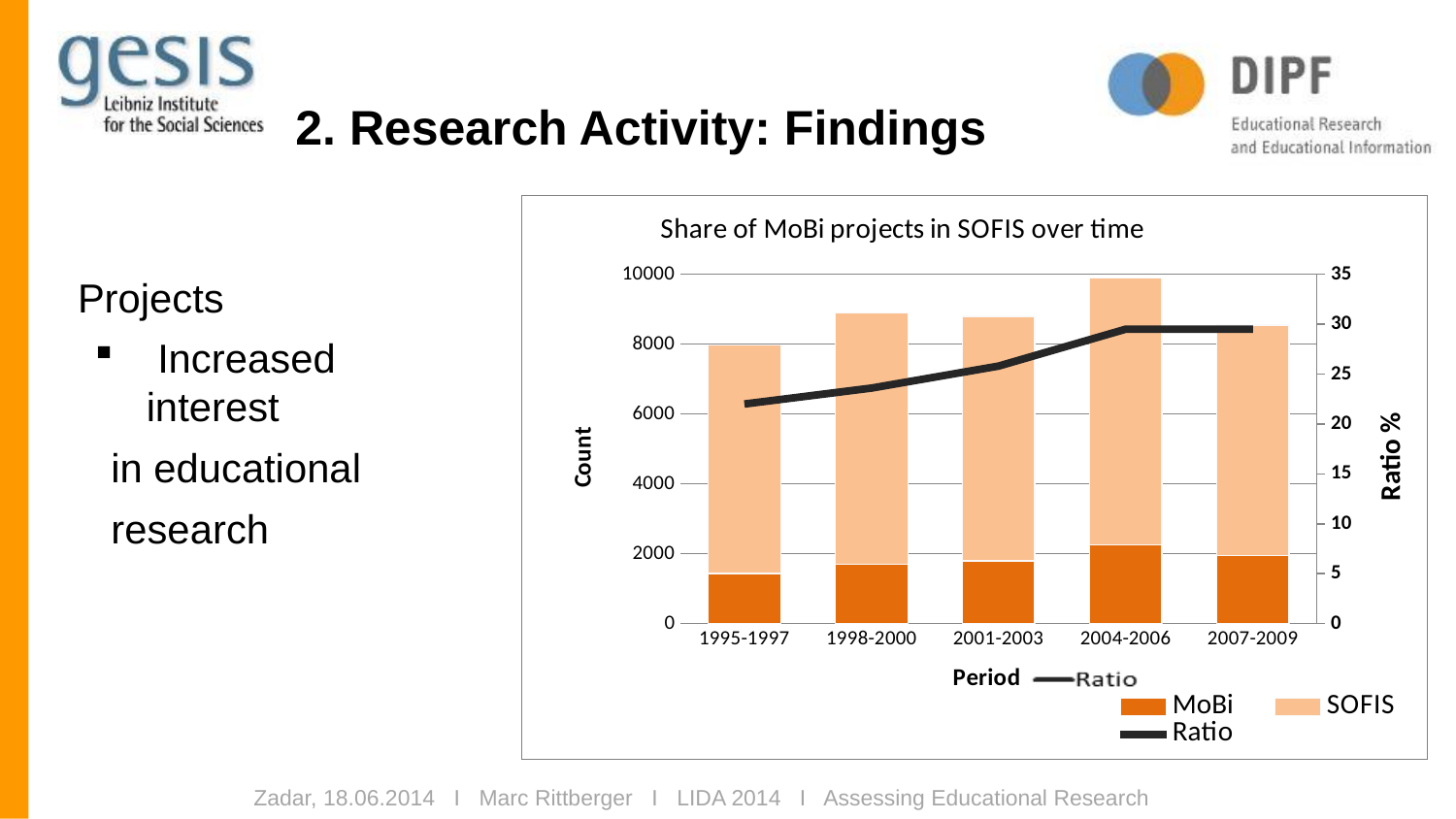
How many periods are shown on the x axis of the chart? 5 Is the total stacked bar for 2004-2006 greater or less than 9000? greater What is the title of the chart? Share of MoBi projects in SOFIS over time Is the MoBi value for 1995-1997 greater or less than 2000? less Which period has the tallest stacked bar in the chart? 2004-2006 Does the Ratio line generally rise or fall from 1995-1997 to 2007-2009? rise Which period has the larger total stacked bar, 2004-2006 or 2007-2009? 2004-2006 Is the MoBi value for 2004-2006 greater or less than 2000? greater What kind of chart is shown on the slide? A stacked bar chart combined with a line How many series does the chart's legend list? 3 Which period has the shortest stacked bar in the chart? 1995-1997